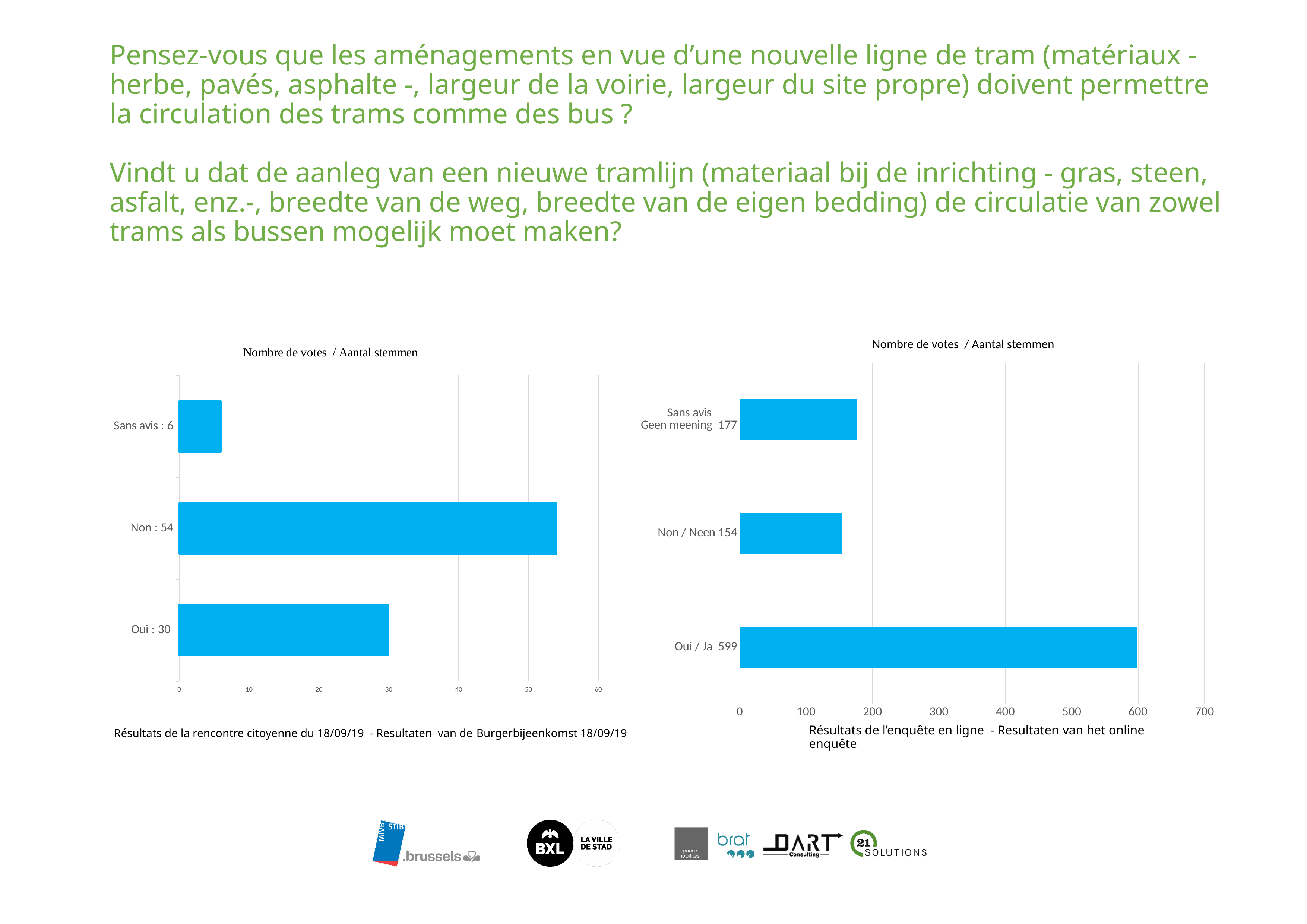
In the left chart (Résultats de la rencontre citoyenne du 18/09/19), how many categories are shown? 3 In the right chart (Résultats de l'enquête en ligne), which category has the highest number of votes? Oui / Ja In the right chart (Résultats de l'enquête en ligne), how many votes did "Oui / Ja" receive? 599 In the left chart (Résultats de la rencontre citoyenne du 18/09/19), how many votes did "Non" receive? 54 What type of chart is the right chart (Résultats de l'enquête en ligne)? Bar chart What is the title shown above the left chart? Nombre de votes / Aantal stemmen In the right chart (Résultats de l'enquête en ligne), how many votes did "Sans avis / Geen meening" receive? 177 In the left chart (Résultats de la rencontre citoyenne du 18/09/19), what is the difference in votes between "Non" and "Oui"? 24 In the left chart (Résultats de la rencontre citoyenne du 18/09/19), how many votes did "Oui" receive? 30 In the right chart (Résultats de l'enquête en ligne), which received more votes, "Non / Neen" or "Sans avis / Geen meening"? Sans avis / Geen meening In the left chart (Résultats de la rencontre citoyenne du 18/09/19), which category has the lowest number of votes? Sans avis In the right chart (Résultats de l'enquête en ligne), what is the difference in votes between "Oui / Ja" and "Non / Neen"? 445